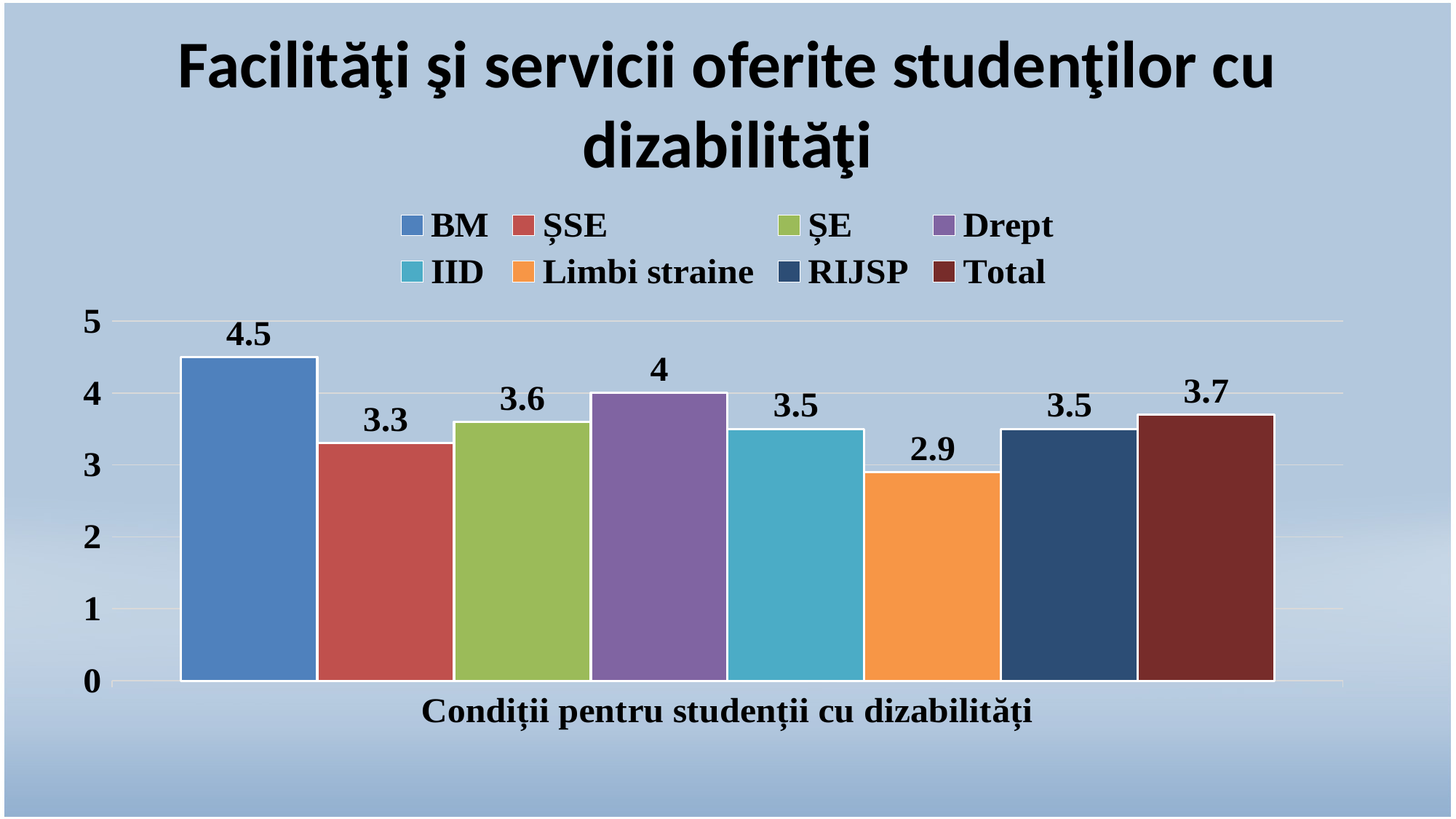
What is the value for Limbi straine? 2.9 What is the value for BM? 4.5 What is the difference between the values for BM and ȘSE? 1.2 Which is larger, the value for ȘE or the value for IID? ȘE Which series has the lowest value? Limbi straine Which series has the highest value? BM What is the value for Total? 3.7 What is the x-axis label of the chart? Condiții pentru studenții cu dizabilități Is the value for RIJSP greater or less than 4? less How many series does the legend list? 8 What kind of chart is shown on the slide? bar chart What is the value for Drept? 4